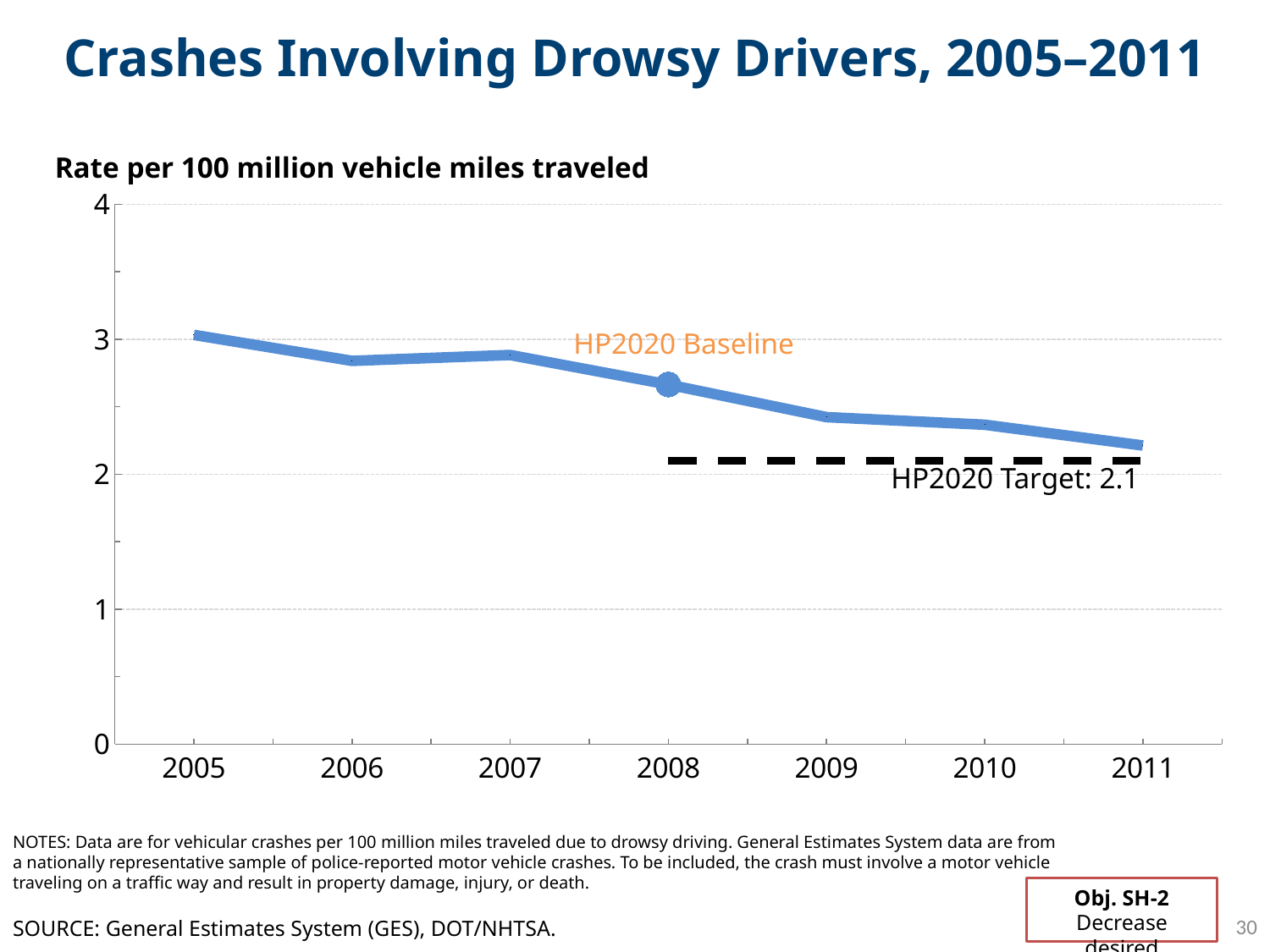
Is the value for 2009 greater or less than 3? less What unit is the rate measured in, according to the axis label? Rate per 100 million vehicle miles traveled What is the HP2020 Target value shown on the chart? 2.1 What kind of chart is shown on the slide? line chart Is the value for 2008 greater or less than 3? less Is the value for 2011 greater or less than 2? greater Which year has the larger crash rate, 2005 or 2011? 2005 How many years are plotted on the x axis of the chart? 7 Which year is marked as the HP2020 Baseline? 2008 Which year has the highest crash rate? 2005 Which year has the lowest crash rate? 2011 Do the crash rates rise or fall from 2005 to 2011? fall